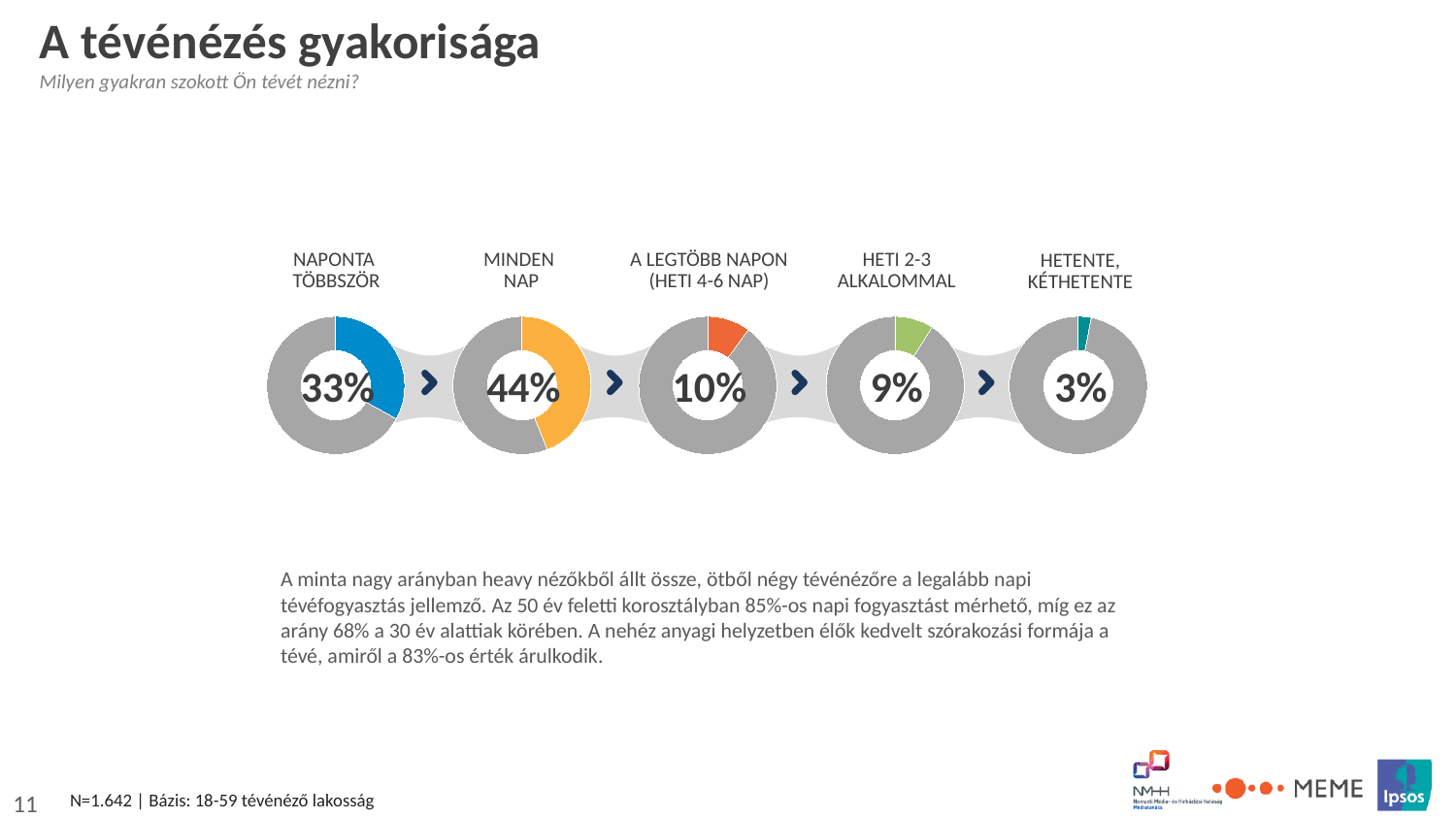
Across the donut charts on the slide, what is the difference between the "Minden nap" value and the "Naponta többször" value? 11% How many donut charts are shown on the slide? 5 In the donut chart labelled "Hetente, kéthetente", what percentage is shown? 3% In the donut chart labelled "Naponta többször", what percentage is shown? 33% In the donut chart labelled "Minden nap", what percentage is shown? 44% What kind of chart is used to show each frequency category on the slide? Donut (pie) chart In the donut chart labelled "A legtöbb napon (heti 4-6 nap)", what percentage is shown? 10% Across the donut charts on the slide, which is larger: the value for "A legtöbb napon (heti 4-6 nap)" or the value for "Heti 2-3 alkalommal"? A legtöbb napon (heti 4-6 nap) Across the five donut charts on the slide, which category has the lowest percentage? Hetente, kéthetente What colour is the highlighted segment in the "Naponta többször" donut chart? Blue In the donut chart labelled "Heti 2-3 alkalommal", what percentage is shown? 9% Across the five donut charts on the slide, which category has the highest percentage? Minden nap